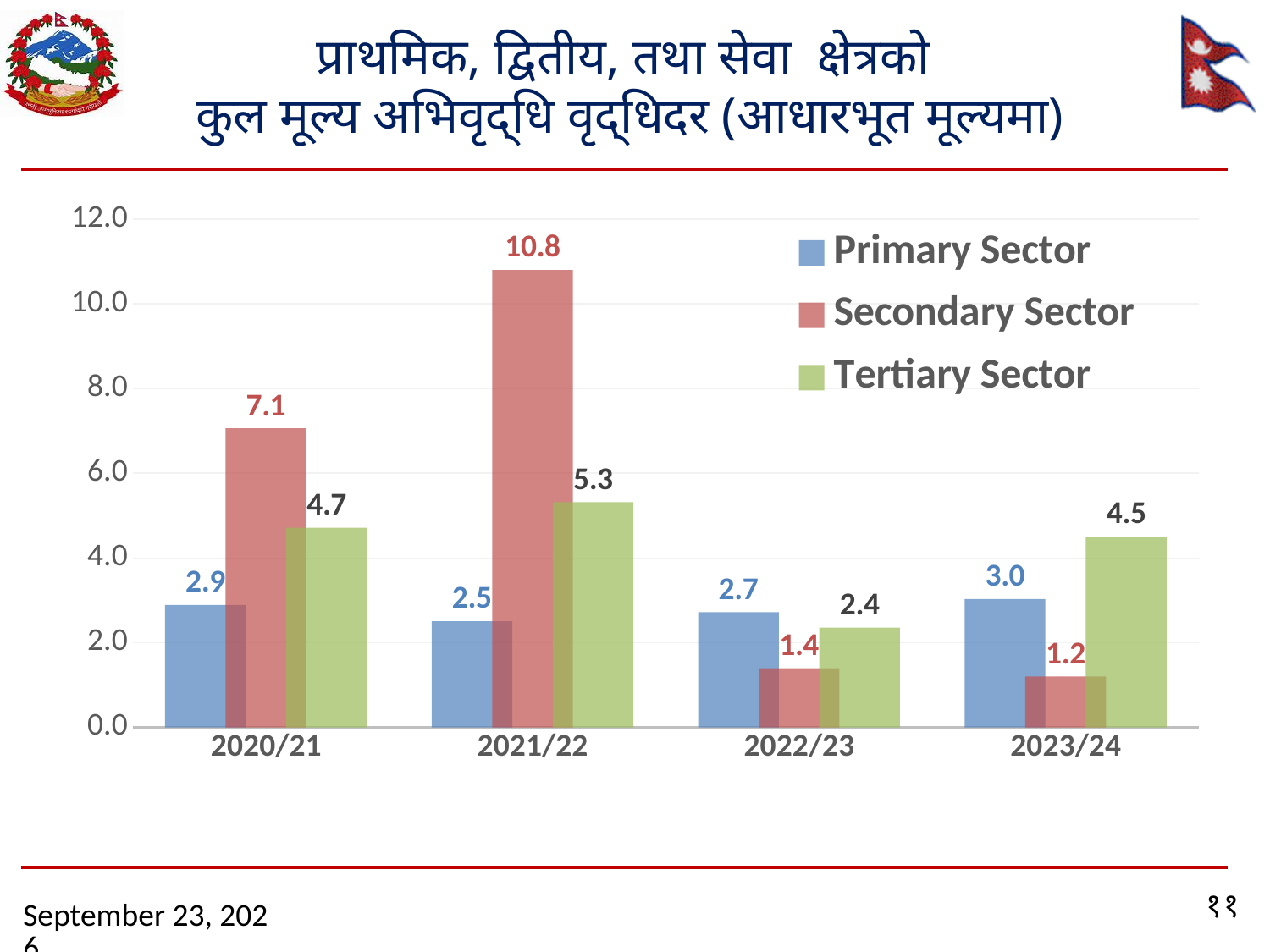
In which year is the Secondary Sector value highest? 2021/22 Is the value for the Secondary Sector in 2021/22 greater or less than 10.0? greater What is the difference between the Secondary Sector values in 2020/21 and 2021/22? 3.7 What kind of chart is shown on the slide? Bar chart In which year is the Secondary Sector value lowest? 2023/24 What is the value for the Secondary Sector in 2021/22? 10.8 Which colour represents the Tertiary Sector in the legend? Green How many series does the legend list? 3 How many years are shown on the x axis? 4 What is the value for the Primary Sector in 2022/23? 2.7 Which is larger in 2022/23, the Primary Sector or the Tertiary Sector? Primary Sector What is the value for the Tertiary Sector in 2023/24? 4.5